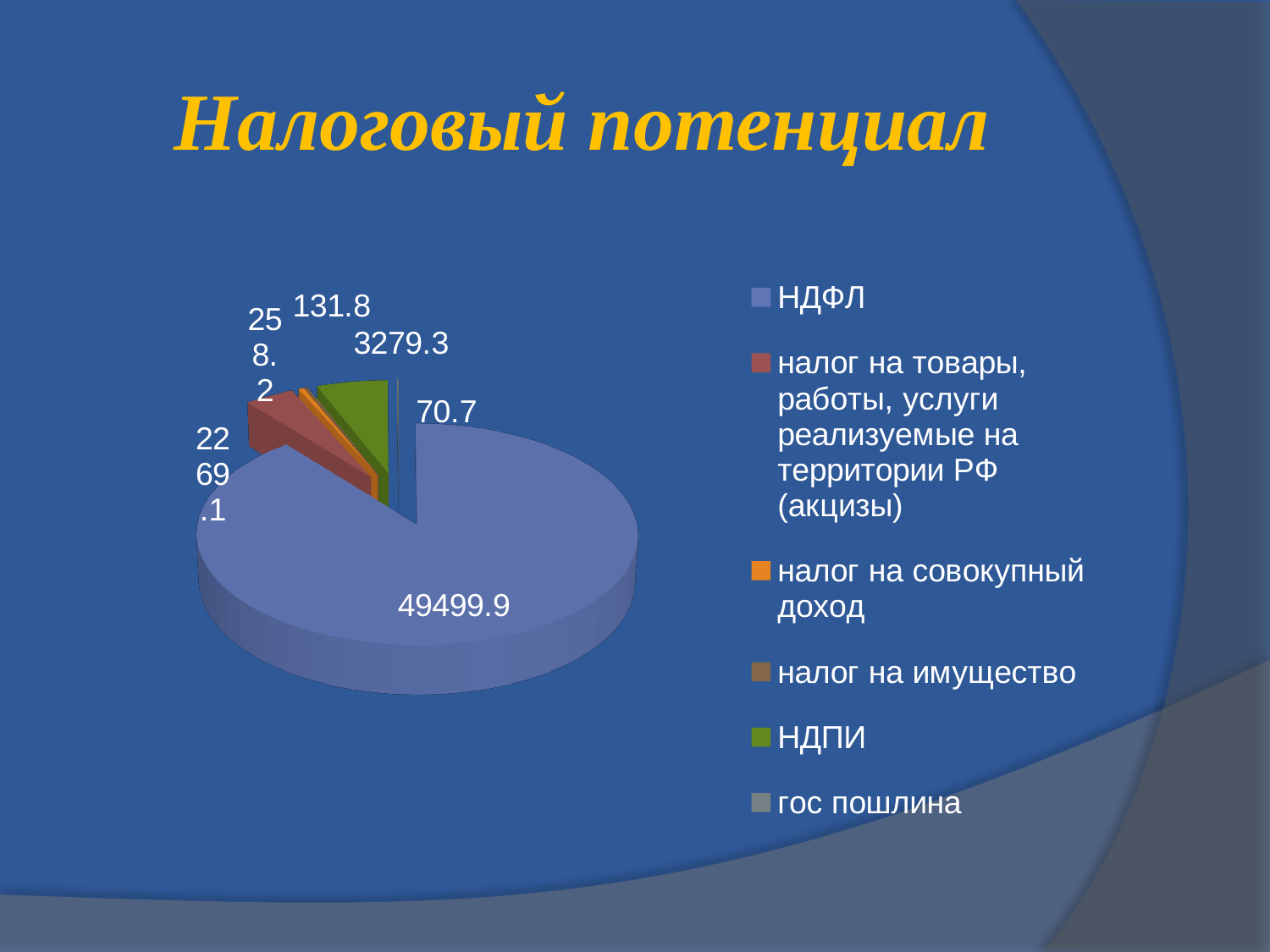
How many slices does the pie chart have? 6 Which category has the largest slice in the pie chart? НДФЛ What is the title of the chart on the slide? Налоговый потенциал What is the value shown for НДФЛ in the pie chart? 49499.9 Which colour represents НДПИ in the pie chart legend? green How many categories does the legend of the pie chart list? 6 Which category has the smallest slice in the pie chart? гос пошлина What is the value shown for НДПИ in the pie chart? 3279.3 Which is larger in the pie chart: НДПИ or налог на товары, работы, услуги реализуемые на территории РФ (акцизы)? НДПИ What is the difference between the values for НДФЛ and НДПИ in the pie chart? 46220.6 What is the value shown for гос пошлина in the pie chart? 70.7 What kind of chart is shown on the slide? pie chart